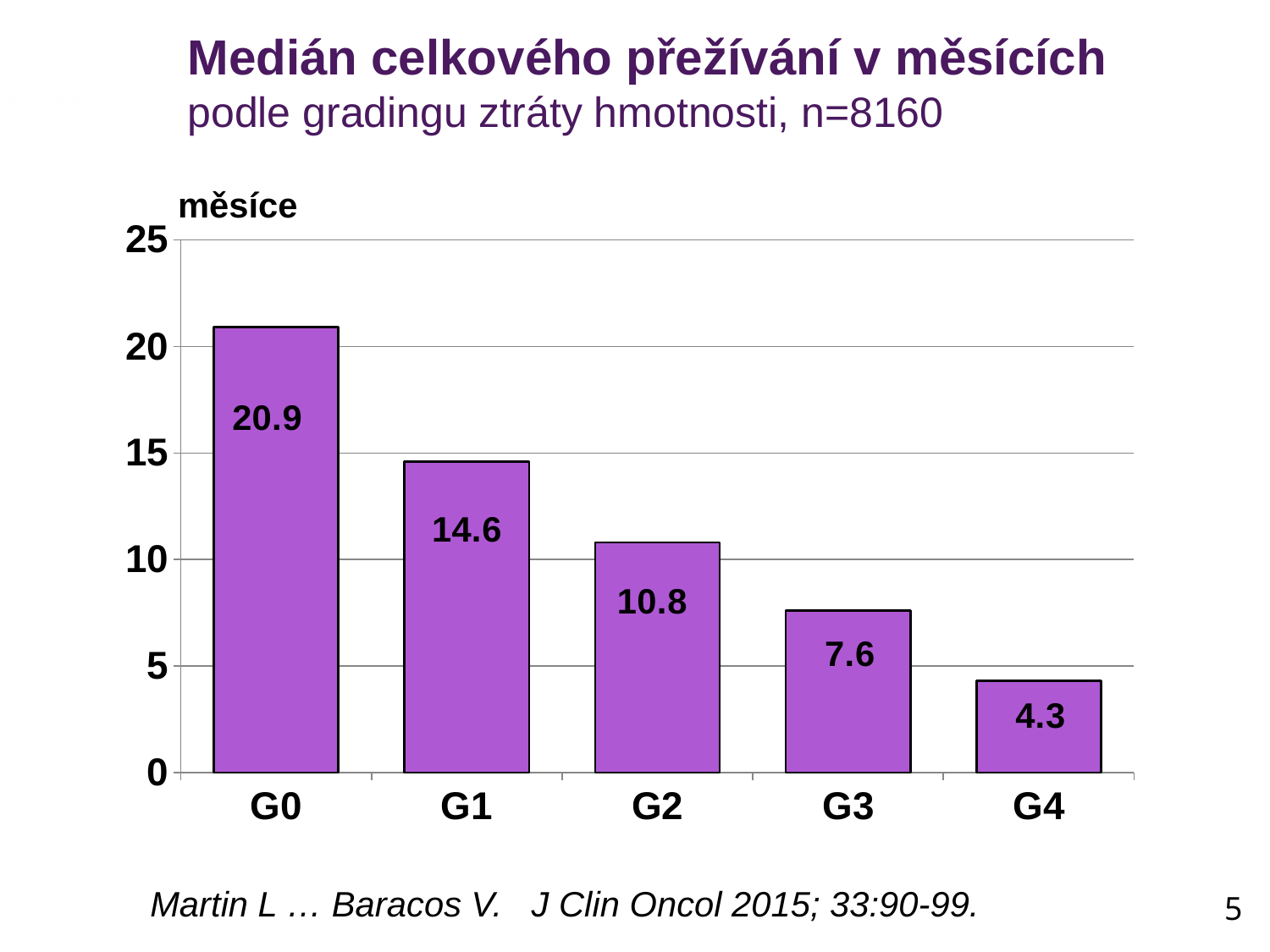
What kind of chart is shown on the slide? bar chart Which grade has the lowest median survival? G4 What is the difference between the values for G0 and G1? 6.3 What is the value shown for G2? 10.8 What is the median overall survival in months for G0? 20.9 Do the values rise or fall from G0 to G4? fall How many grade categories are shown on the x axis? 5 Is the value for G2 greater or less than 10? greater Which grade has the highest median survival? G0 What is the difference between the values for G3 and G4? 3.3 Which is larger, the value for G1 or the value for G3? G1 What is the value shown for G4? 4.3